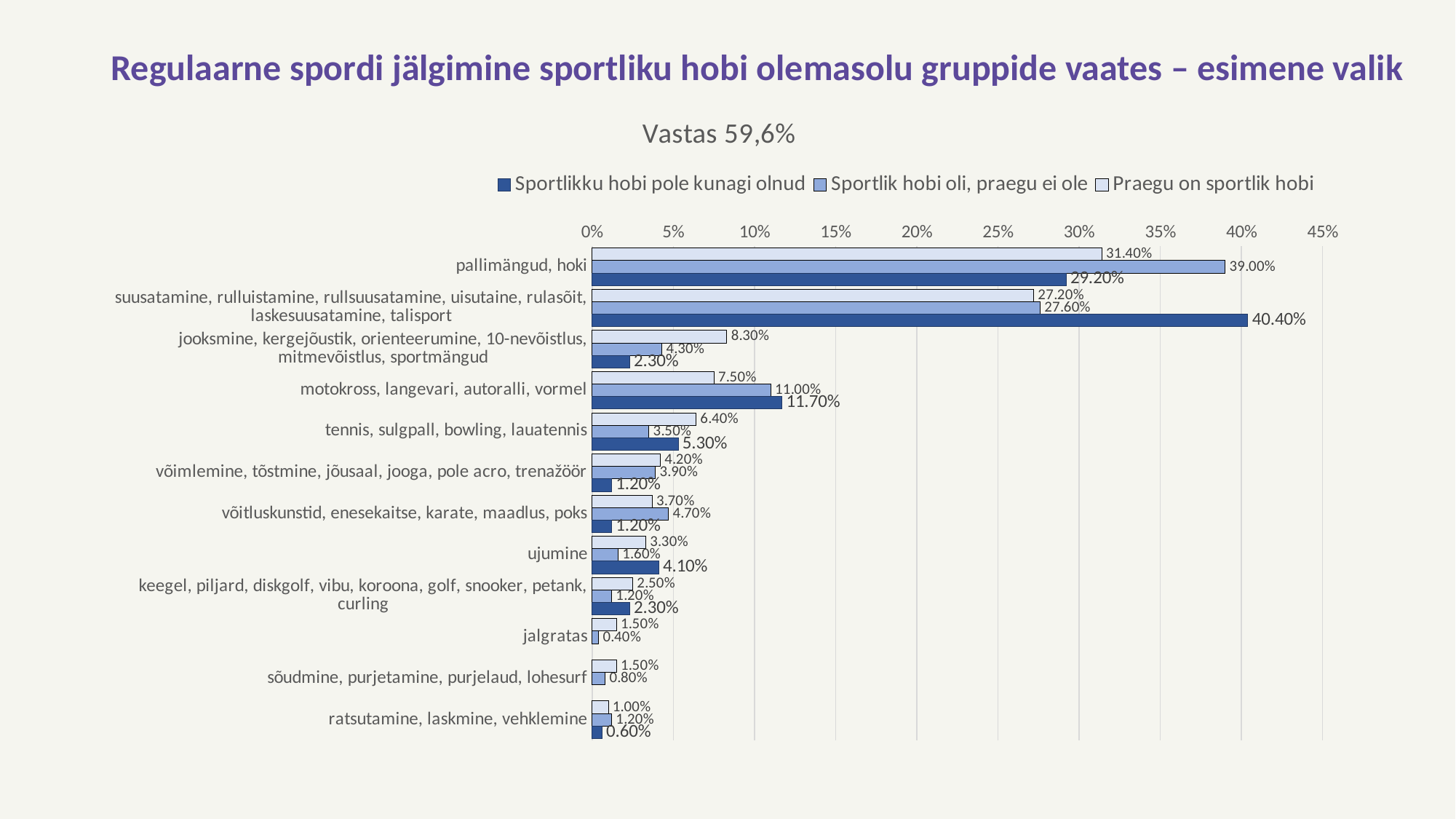
What is the value for 'Sportlikku hobi pole kunagi olnud' in the category 'motokross, langevari, autoralli, vormel'? 11.70% What is the value for 'Praegu on sportlik hobi' in the category 'jooksmine, kergejõustik, orienteerumine, 10-nevõistlus, mitmevõistlus, sportmängud'? 8.30% What is the difference between the 'Sportlikku hobi pole kunagi olnud' value and the 'Praegu on sportlik hobi' value for 'pallimängud, hoki'? 2.20% Which category has the lowest value for 'Sportlik hobi oli, praegu ei ole'? jalgratas For 'ujumine', which is larger: the value for 'Sportlikku hobi pole kunagi olnud' or the value for 'Praegu on sportlik hobi'? Sportlikku hobi pole kunagi olnud Is the value for 'Sportlikku hobi pole kunagi olnud' in 'suusatamine, rulluistamine, rullsuusatamine, uisutaine, rulasõit, laskesuusatamine, talisport' greater or less than 35%? greater How many categories are shown on the vertical axis of the chart? 12 How many series does the legend list? 3 What kind of chart is shown on the slide? bar chart What is the value for 'Sportlik hobi oli, praegu ei ole' in the category 'pallimängud, hoki'? 39.00% Which category has the highest value for 'Sportlikku hobi pole kunagi olnud'? suusatamine, rulluistamine, rullsuusatamine, uisutaine, rulasõit, laskesuusatamine, talisport What response rate is stated in the subtitle below the chart title? Vastas 59,6%